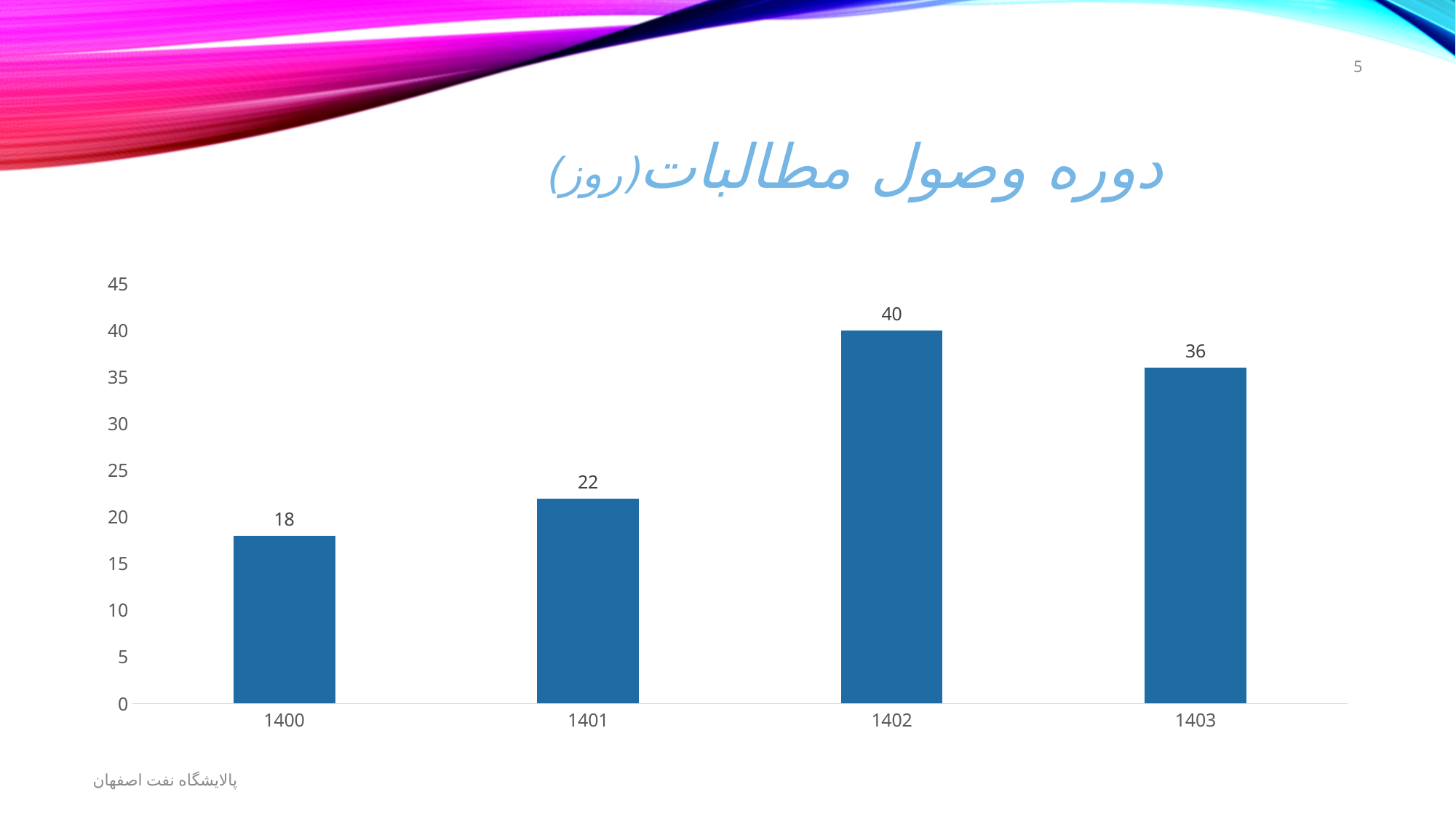
Is the value for 1401 greater or less than 25? less Which year has the highest value? 1402 What is the difference between the values for 1403 and 1400? 18 How many years are shown on the x axis? 4 What is the value for 1400? 18 What is the value for 1403? 36 Does the value rise or fall from 1402 to 1403? fall What is the difference between the values for 1402 and 1401? 18 What kind of chart is shown on the slide? bar chart Which is larger, the value for 1401 or the value for 1403? 1403 Which year has the lowest value? 1400 What is the value for 1402? 40